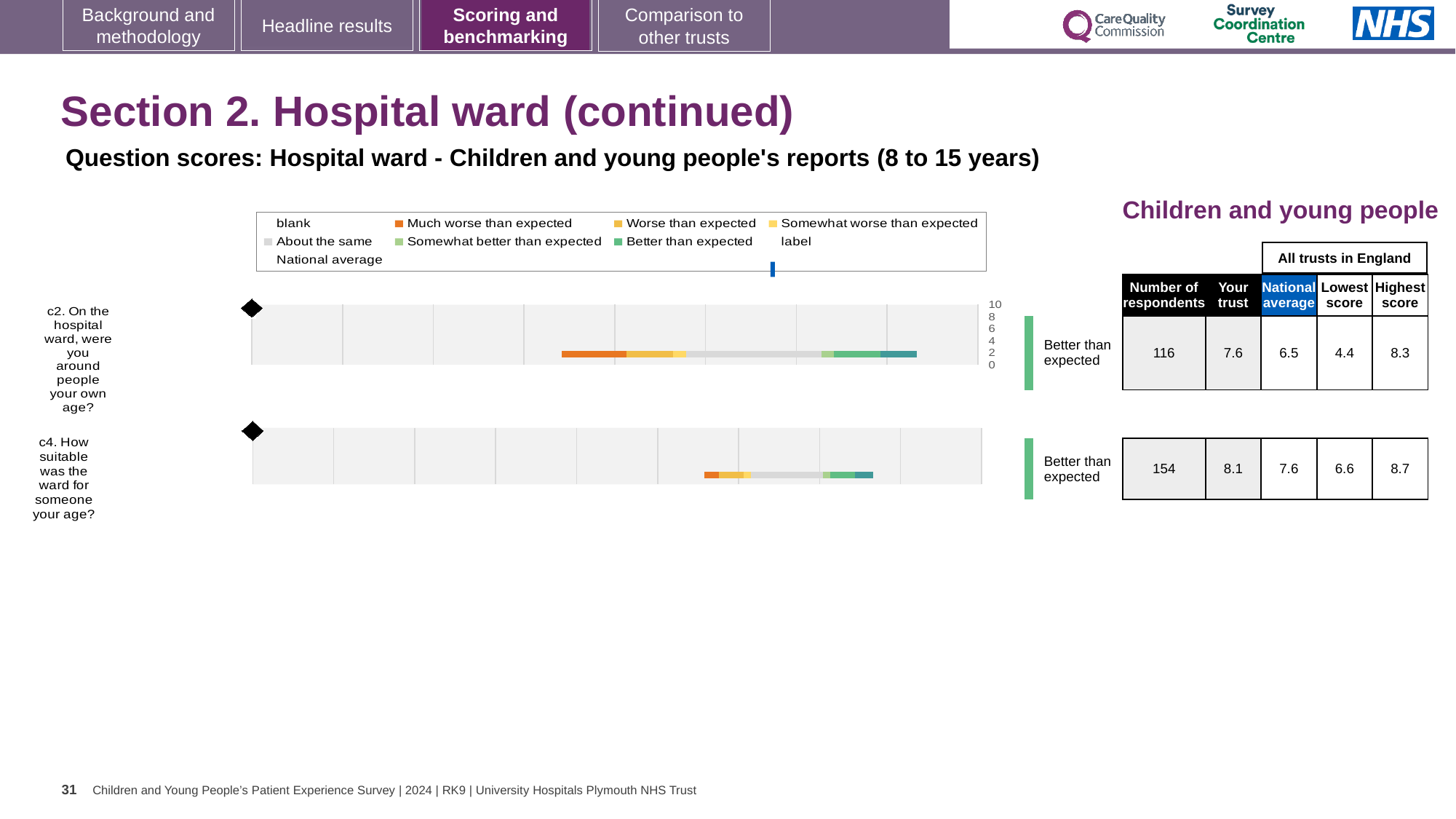
What kind of chart is used to show the question scores for c2 and c4? bar chart What is the 'Your trust' score for c2 (On the hospital ward, were you around people your own age?)? 7.6 Which question has the higher 'Your trust' score, c2 or c4? c4 What benchmark category is shown for c4? Better than expected What is the national average score for c2? 6.5 What is the difference between the highest and lowest scores for c4? 2.1 What is the number of respondents for c4 (How suitable was the ward for someone your age?)? 154 What is the lowest score across all trusts in England for c2? 4.4 Which question has more respondents, c2 or c4? c4 How many questions are plotted on the chart? 2 What is the difference between the trust score and the national average for c2? 1.1